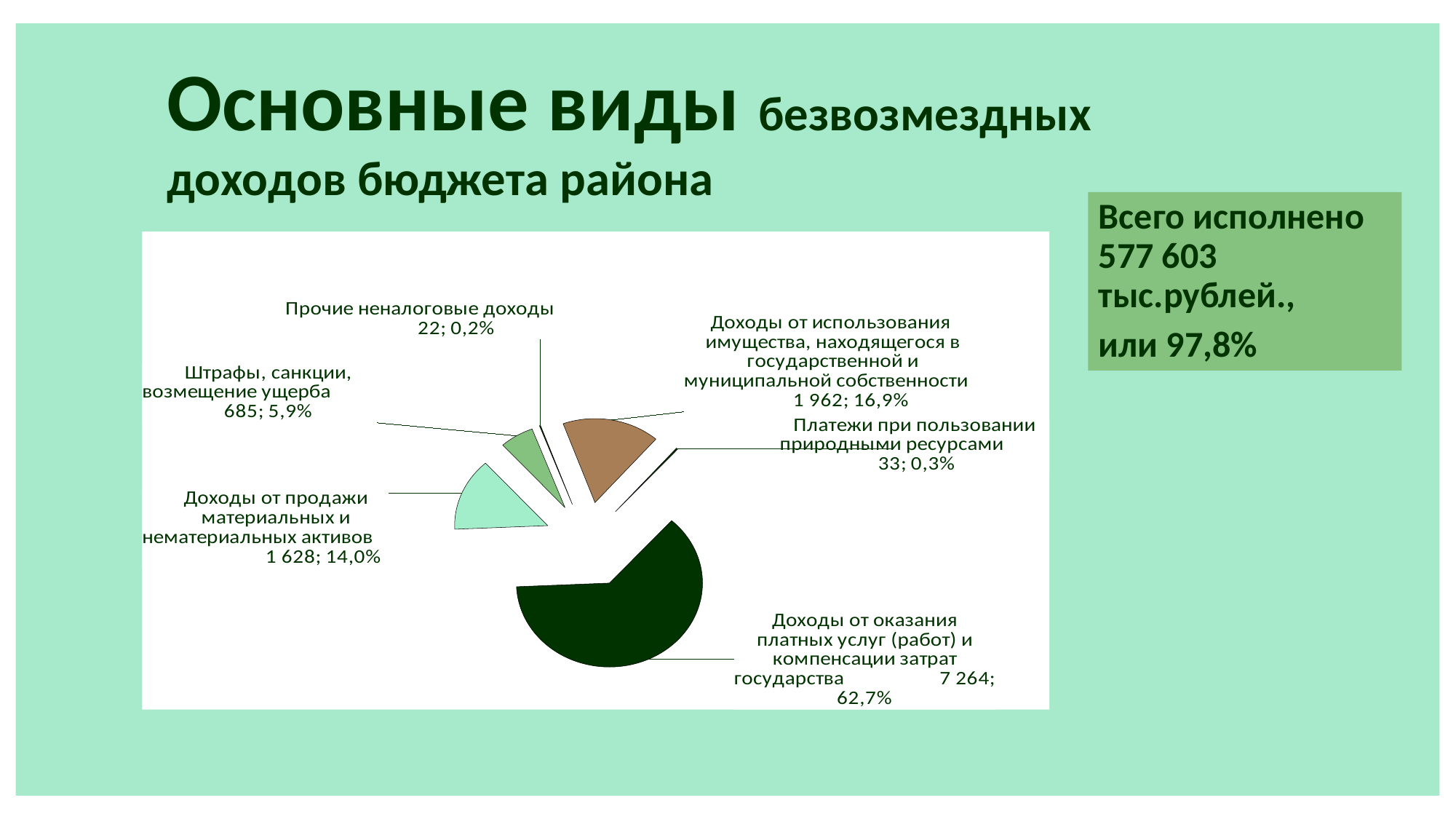
What value is shown for "Доходы от оказания платных услуг (работ) и компенсации затрат государства"? 7 264 Which is larger: "Доходы от использования имущества, находящегося в государственной и муниципальной собственности" or "Доходы от продажи материальных и нематериальных активов"? Доходы от использования имущества, находящегося в государственной и муниципальной собственности Which category has the smallest slice of the pie? Прочие неналоговые доходы What value is shown for "Платежи при пользовании природными ресурсами"? 33 What kind of chart is shown on the slide? pie chart What total executed amount is stated in the box to the right of the chart? 577 603 тыс.рублей, или 97,8% What share of the pie does "Доходы от оказания платных услуг (работ) и компенсации затрат государства" have? 62,7% What percentage is shown for "Штрафы, санкции, возмещение ущерба"? 5,9% What is the difference between the values for "Доходы от использования имущества, находящегося в государственной и муниципальной собственности" (1 962) and "Доходы от продажи материальных и нематериальных активов" (1 628)? 334 What value is shown for "Доходы от продажи материальных и нематериальных активов"? 1 628 Which category has the largest slice of the pie? Доходы от оказания платных услуг (работ) и компенсации затрат государства How many slices does the pie chart have? 6